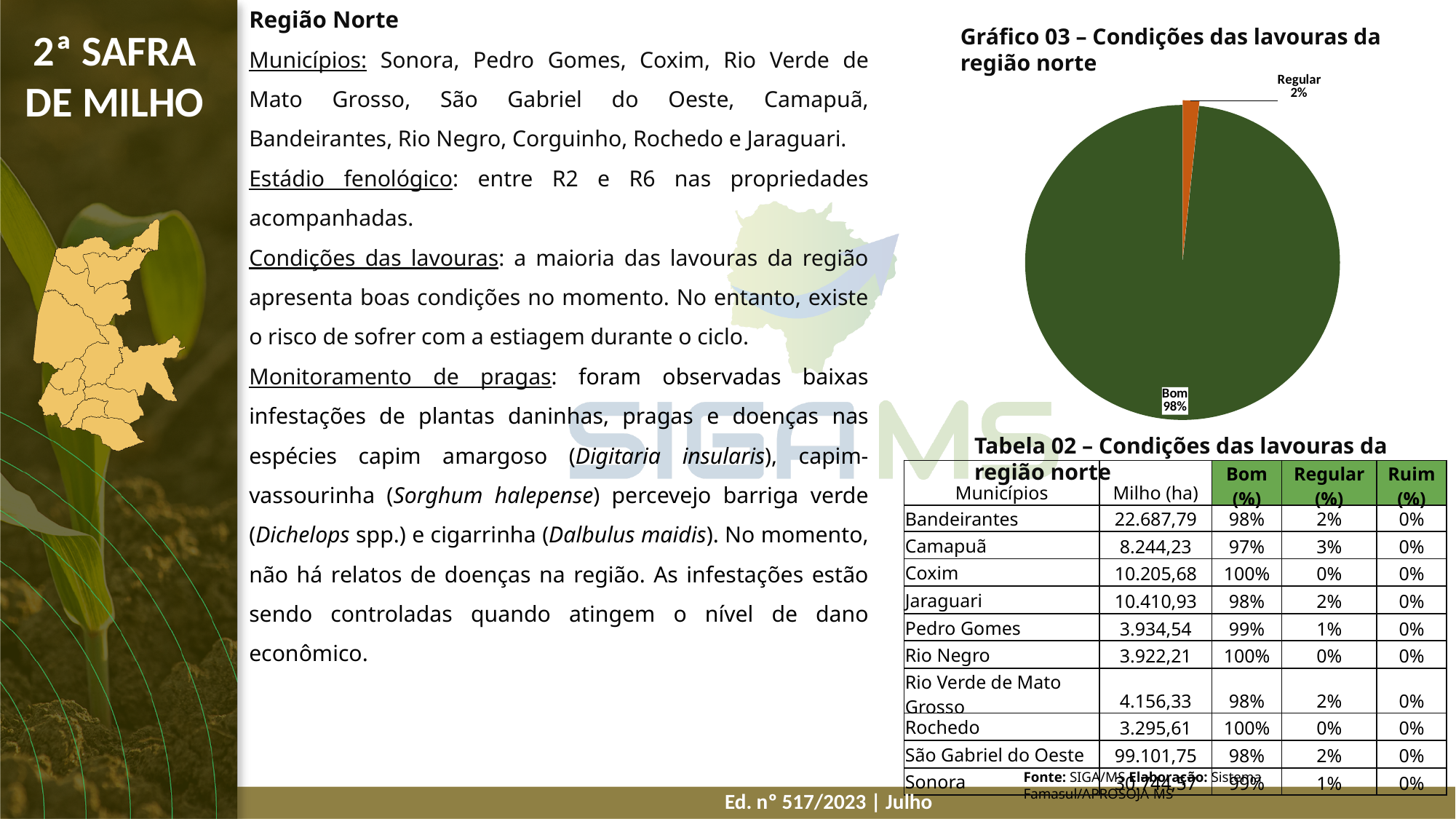
What is the title of the pie chart on the slide? Gráfico 03 – Condições das lavouras da região norte In Gráfico 03, what is the difference in percentage points between the 'Bom' and 'Regular' slices? 96 percentage points In Gráfico 03, which slice is larger, 'Bom' or 'Regular'? Bom In Gráfico 03, what percentage of the crops are in the 'Bom' condition? 98% In Gráfico 03, what share of the pie does the 'Regular' slice represent? 2% What kind of chart is Gráfico 03 – Condições das lavouras da região norte? Pie chart In Gráfico 03, which condition category has the smallest slice? Regular In Gráfico 03, what percentage of the crops are in the 'Regular' condition? 2% In Gráfico 03, what colour is the 'Bom' slice? Dark green In Gráfico 03, how many slices does the pie chart have? 2 In Gráfico 03, which condition category has the largest slice? Bom In Gráfico 03, is the value for 'Bom' greater or less than 50%? greater